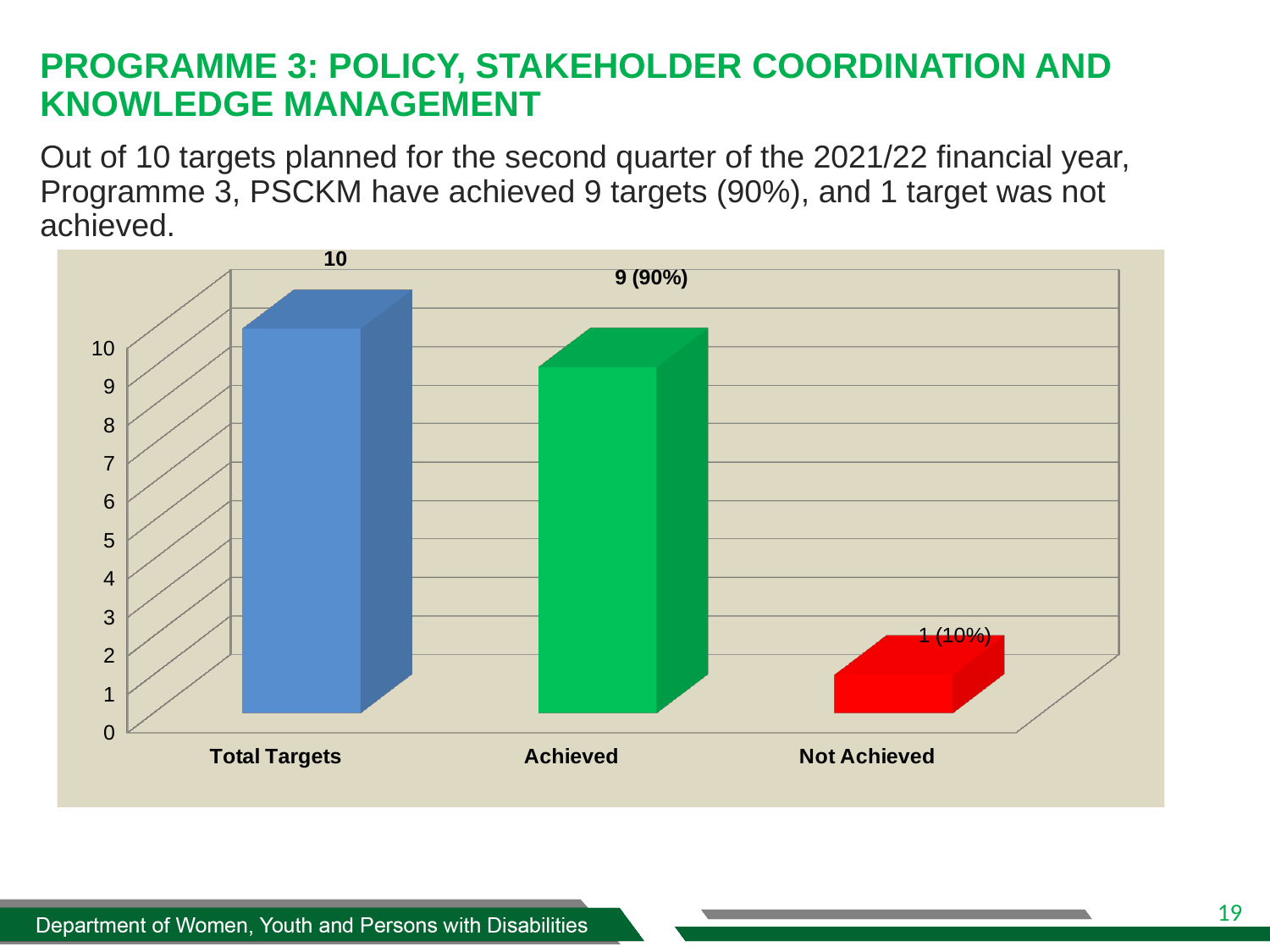
What colour is the Not Achieved bar? red How many categories are shown on the x axis? 3 What is the value shown for Total Targets? 10 What data label is shown for the Not Achieved bar? 1 (10%) Which is larger, Achieved or Not Achieved? Achieved Which category has the highest value? Total Targets What is the difference between Total Targets and Achieved? 1 What data label is shown for the Achieved bar? 9 (90%) Is the value for Achieved greater or less than 5? greater What is the difference between the Achieved and Not Achieved values? 8 What kind of chart is shown on the slide? bar chart Which category has the lowest value? Not Achieved